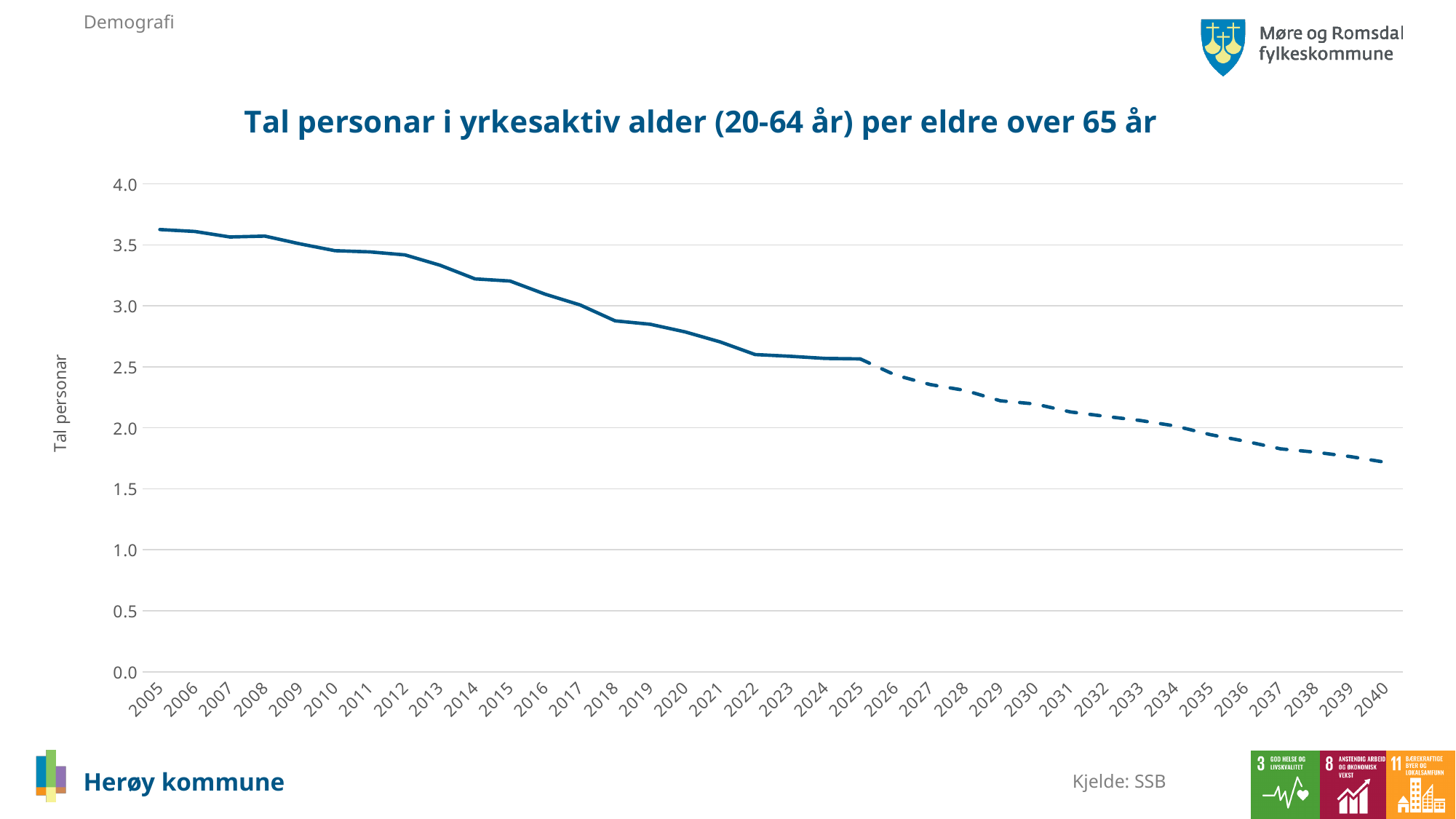
What is the title of the chart? Tal personar i yrkesaktiv alder (20-64 år) per eldre over 65 år Is the value for 2030 greater or less than 2.0? greater What kind of chart is shown on the slide? line chart Which is larger, the value for 2010 or the value for 2020? 2010 Is the value for 2018 greater or less than 3.0? less Do the values rise or fall from 2005 to 2040? fall How many years are shown on the x axis? 36 Which year has the lowest value? 2040 Is the value for 2040 greater or less than 2.0? less What is the label on the vertical axis? Tal personar Which year has the highest value? 2005